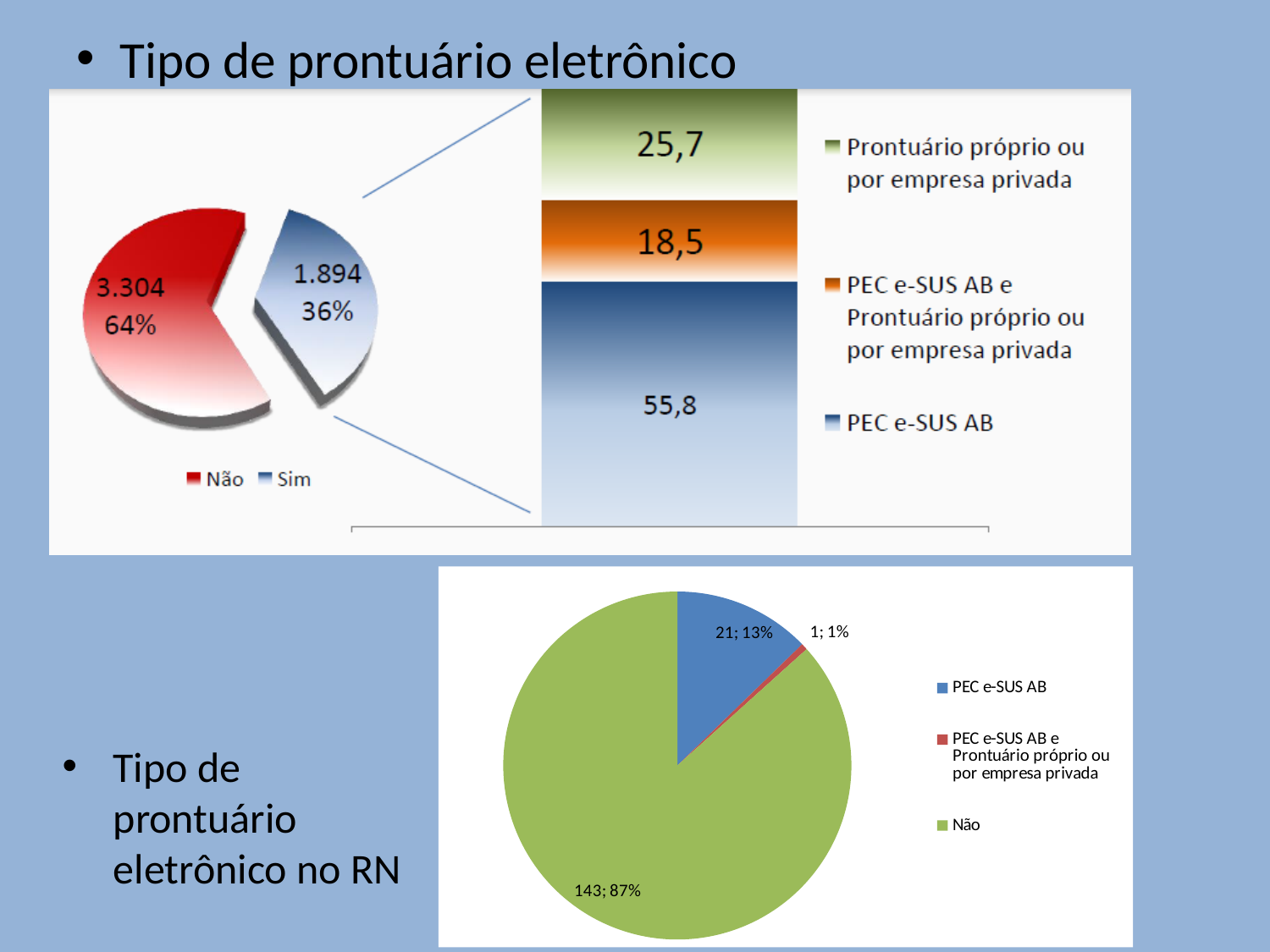
In the bottom pie chart, what percentage share does 'PEC e-SUS AB' have? 13% What kind of chart is the bottom chart on the slide? Pie chart In the bottom pie chart, what value and percentage are shown for 'Não'? 143; 87% In the top-left pie chart, what percentage share does the 'Sim' slice have? 36% In the top-right stacked bar chart, what value is shown for 'PEC e-SUS AB'? 55,8 In the top-left pie chart, which slice is larger, 'Não' or 'Sim'? Não In the top-right stacked bar chart, which segment has the lowest value? PEC e-SUS AB e Prontuário próprio ou por empresa privada How many series does the legend of the top-left pie chart list? 2 In the top-right stacked bar chart, what is the difference between the 'PEC e-SUS AB' segment and the 'Prontuário próprio ou por empresa privada' segment? 30,1 In the top-left pie chart, what value is shown for the 'Não' slice? 3.304 In the top-right stacked bar chart, what value is shown for 'Prontuário próprio ou por empresa privada'? 25,7 How many slices does the bottom pie chart have? 3